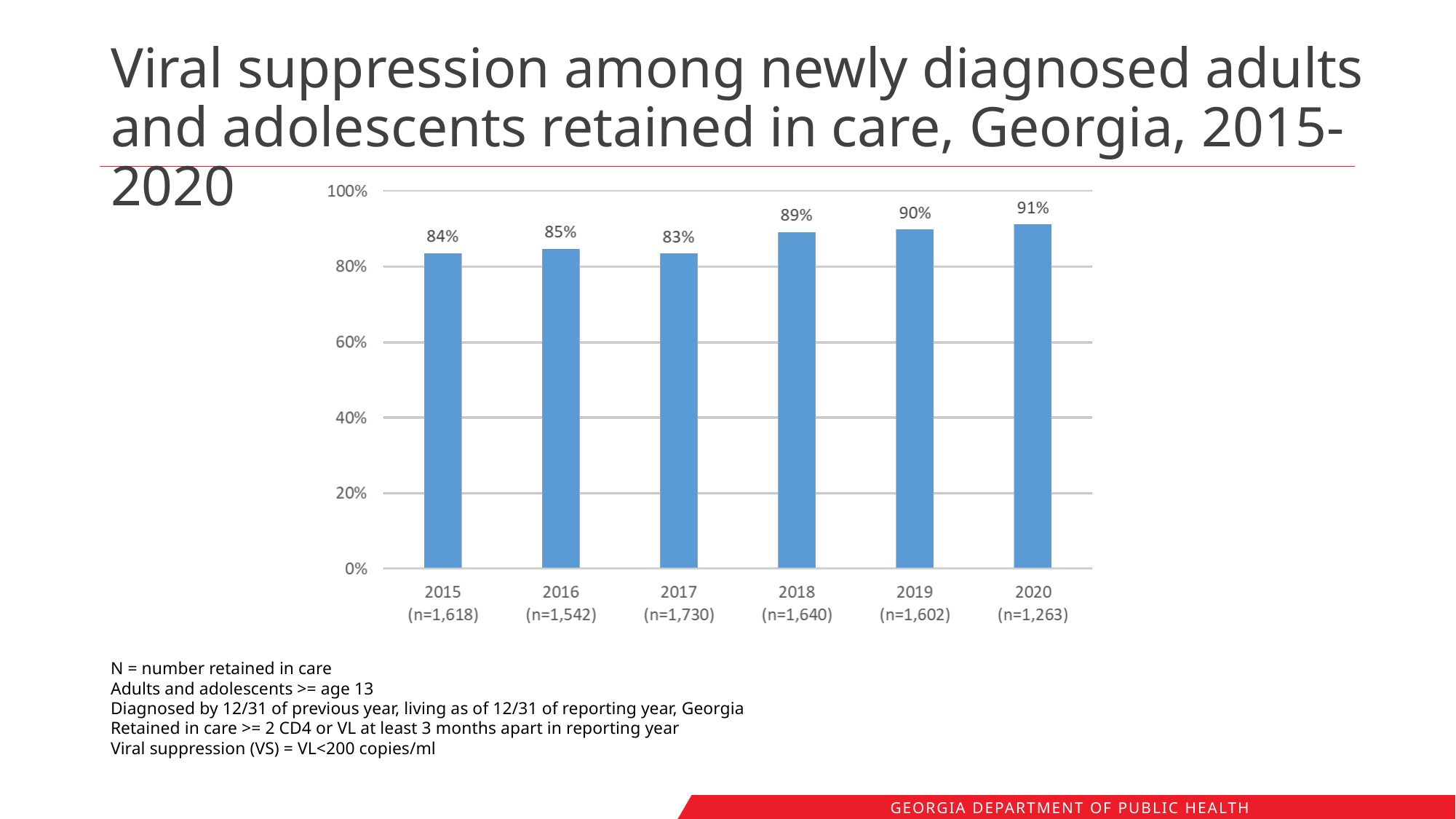
Is the value for 2017 greater or less than 80%? greater Which year has a higher viral suppression percentage, 2016 or 2019? 2019 How many years are shown on the x axis of the chart? 6 Which year has the lowest viral suppression percentage? 2017 What is the difference in viral suppression percentage between 2018 and 2017? 6% What is the number retained in care (n) shown for 2020? 1,263 What is the viral suppression percentage for 2015? 84% What is the difference in viral suppression percentage between 2020 and 2015? 7% Which year has the highest viral suppression percentage? 2020 What is the viral suppression percentage for 2018? 89% What is the viral suppression percentage for 2020? 91% What kind of chart is shown on the slide? Bar chart